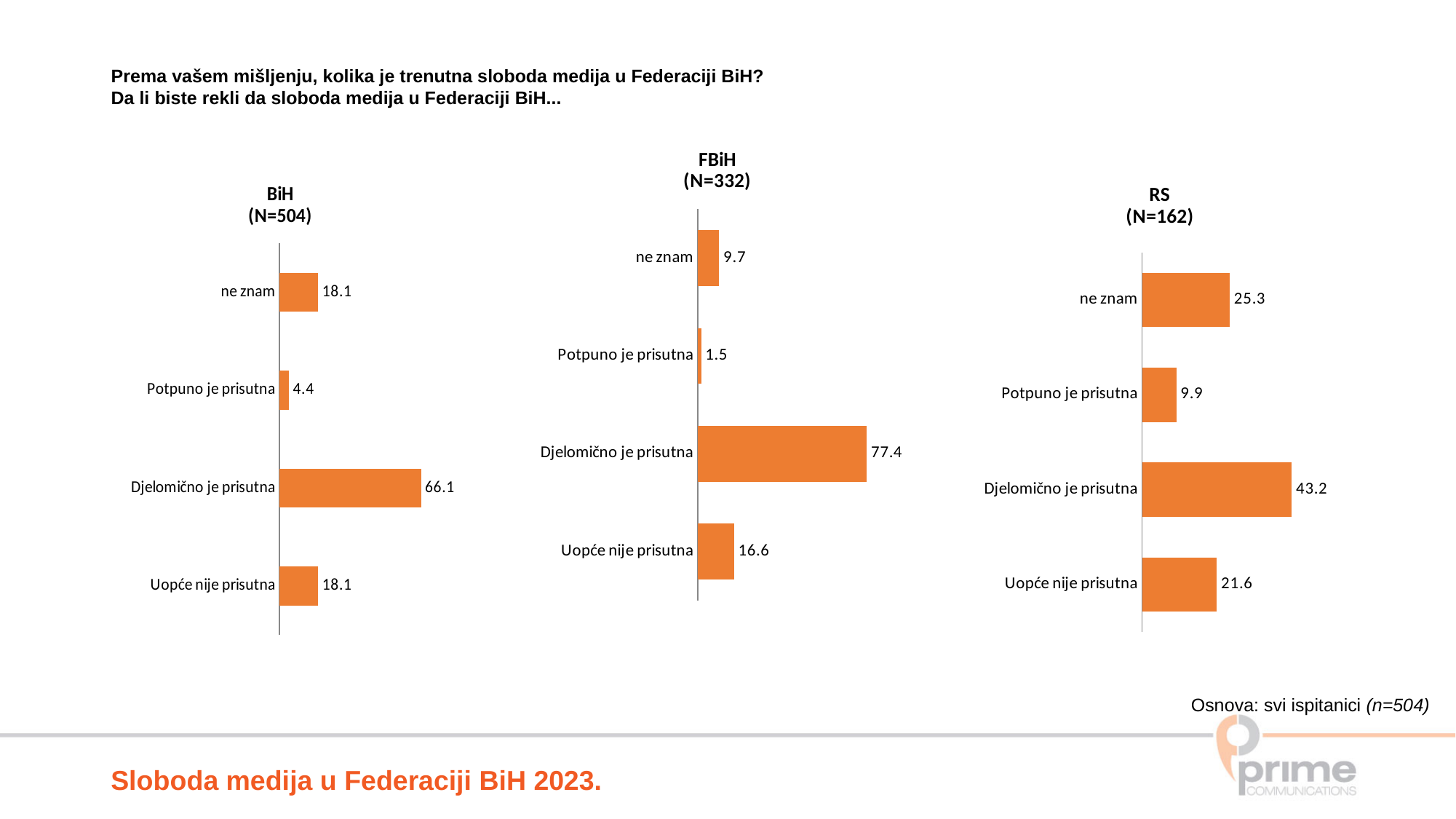
In the FBiH (N=332) chart, what is the difference between "Uopće nije prisutna" and "ne znam"? 6.9 In the RS (N=162) chart, which category has the highest value? Djelomično je prisutna What kind of chart is the FBiH (N=332) chart? bar chart In the BiH (N=504) chart, which category has the lowest value? Potpuno je prisutna In the RS (N=162) chart, what is the value for "Uopće nije prisutna"? 21.6 In the RS (N=162) chart, what is the difference between "Djelomično je prisutna" and "ne znam"? 17.9 In the FBiH (N=332) chart, which category has the lowest value? Potpuno je prisutna How many charts are shown on the slide? 3 How many categories does the RS (N=162) chart show? 4 In the BiH (N=504) chart, which is larger: "ne znam" or "Potpuno je prisutna"? ne znam In the BiH (N=504) chart, what is the value for "Djelomično je prisutna"? 66.1 In the FBiH (N=332) chart, what is the value for "ne znam"? 9.7